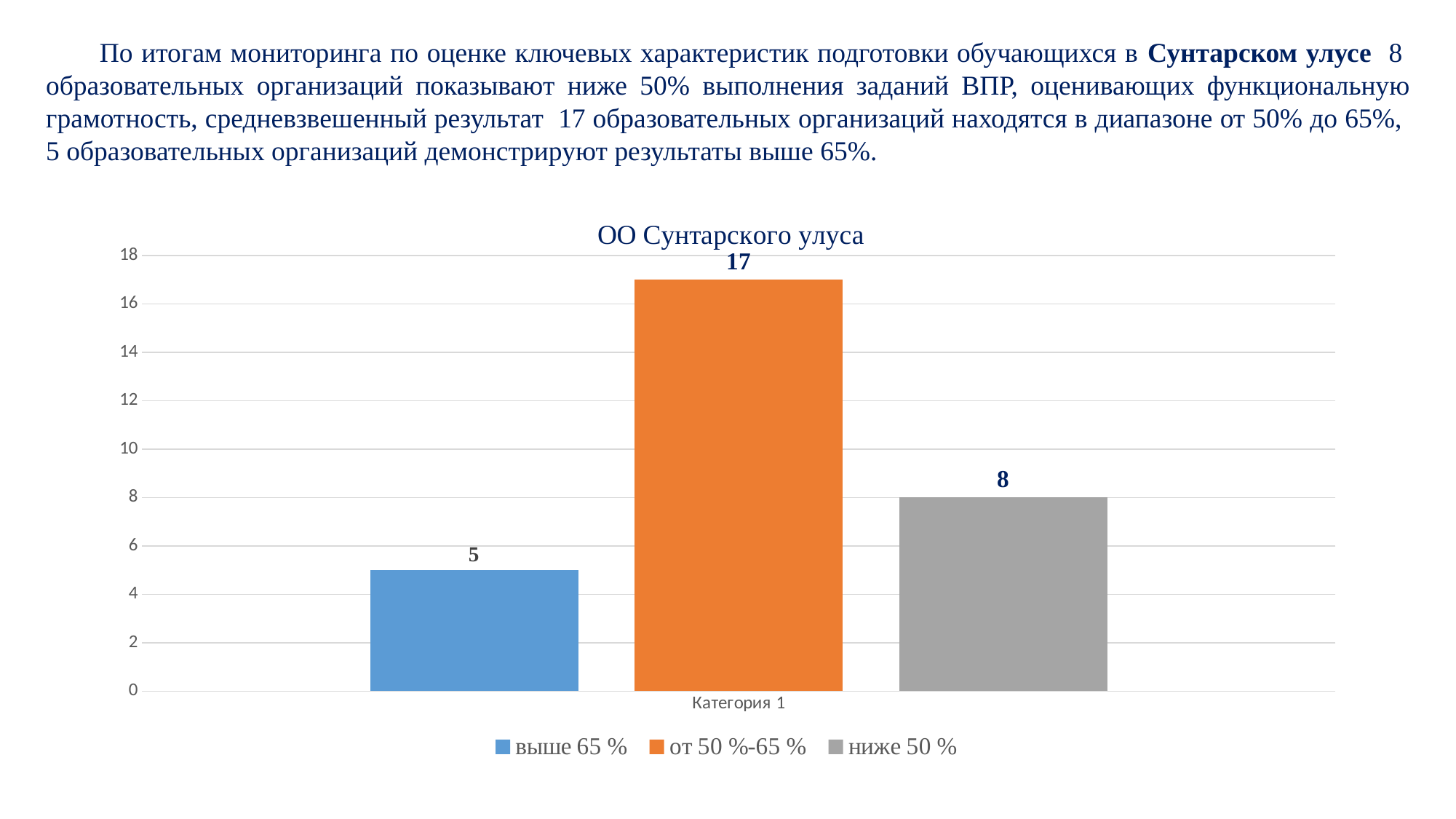
Which series has the highest value? от 50 %-65 % What is the value for the series 'выше 65 %'? 5 What is the value for the series 'ниже 50 %'? 8 What is the difference between the values for 'от 50 %-65 %' and 'ниже 50 %'? 9 Is the value for 'от 50 %-65 %' greater or less than 10? greater What is the difference between the values for 'ниже 50 %' and 'выше 65 %'? 3 How many series does the legend list? 3 What is the title of the chart? ОО Сунтарского улуса Which is larger, the value for 'ниже 50 %' or the value for 'выше 65 %'? ниже 50 % Which series has the lowest value? выше 65 % What kind of chart is shown on the slide? bar chart What is the value for the series 'от 50 %-65 %'? 17